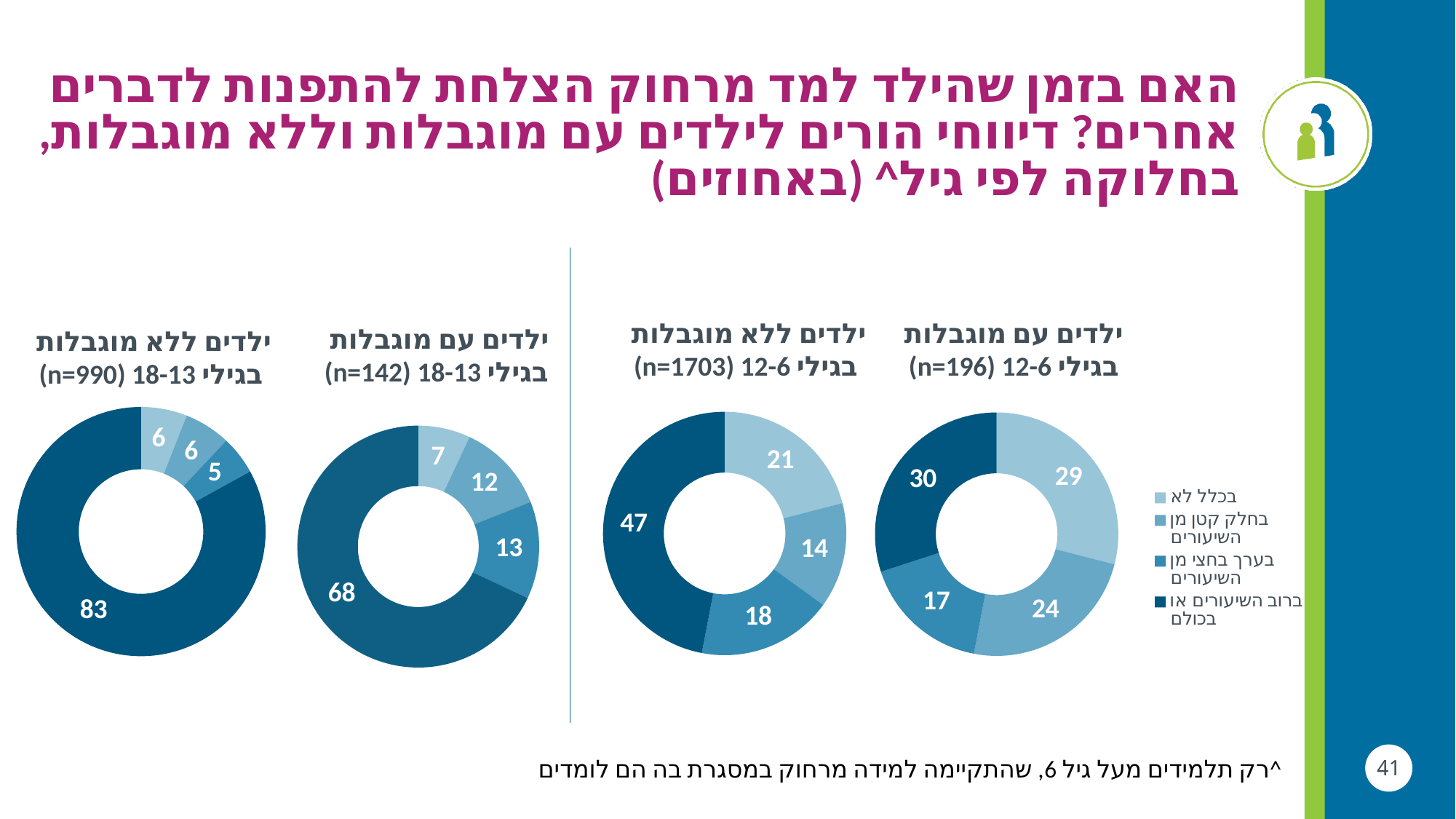
In the chart for ילדים עם מוגבלות בגילי 6-12 (n=196), what is the value for ברוב השיעורים או בכולם? 30 In the chart for ילדים עם מוגבלות בגילי 6-12 (n=196), which is larger: בכלל לא or בערך בחצי מן השיעורים? בכלל לא In the chart for ילדים עם מוגבלות בגילי 13-18 (n=142), what is the value for בחלק קטן מן השיעורים? 12 What is the value for ברוב השיעורים או בכולם in the chart for ילדים ללא מוגבלות בגילי 13-18 (n=990)? 83 In the chart for ילדים ללא מוגבלות בגילי 6-12 (n=1703), what is the difference between ברוב השיעורים או בכולם and בכלל לא? 26 In the chart for ילדים עם מוגבלות בגילי 13-18 (n=142), which category has the smallest share? בכלל לא What type of chart is used on this slide? Donut (pie) chart How many donut charts are shown on the slide? 4 In the chart for ילדים ללא מוגבלות בגילי 6-12 (n=1703), what is the value for בכלל לא? 21 How many categories does the legend list? 4 In the chart for ילדים ללא מוגבלות בגילי 13-18 (n=990), which category has the largest share? ברוב השיעורים או בכולם In the chart for ילדים עם מוגבלות בגילי 6-12 (n=196), what is the value for בערך בחצי מן השיעורים? 17